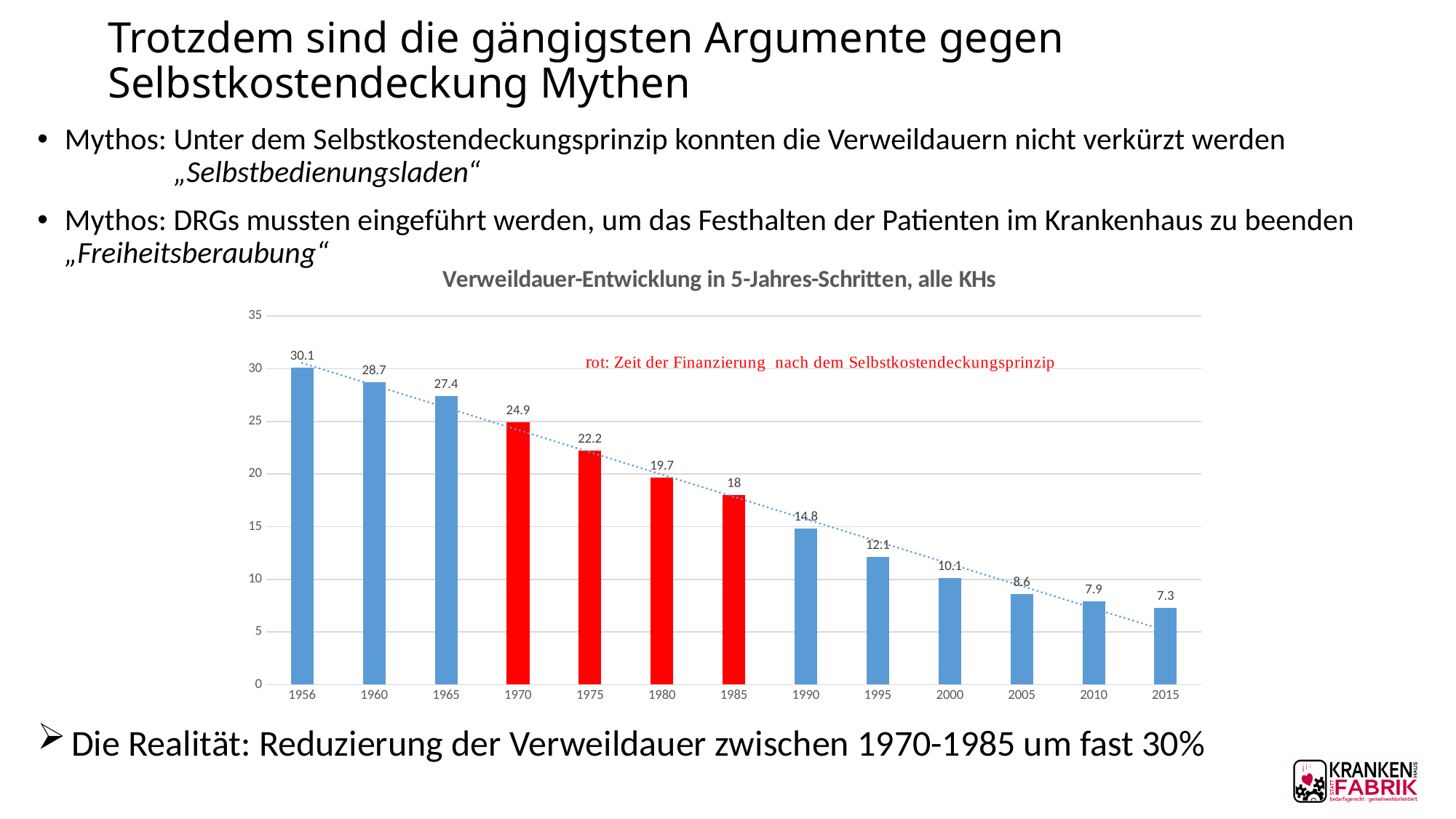
What kind of chart is shown on the slide? bar chart Do the values rise or fall from 1956 to 2015? fall Which is larger, the value for 1980 or the value for 1990? 1980 Is the value for 1975 greater or less than 20? greater What is the value for 2015 in the chart? 7.3 What is the value for 1985 in the chart? 18 What is the value for 1970 in the chart? 24.9 Which year has the lowest value in the chart? 2015 What is the title of the chart? Verweildauer-Entwicklung in 5-Jahres-Schritten, alle KHs How many years are shown on the x axis of the chart? 13 Which year has the highest value in the chart? 1956 What is the difference between the values for 1970 and 1985? 6.9